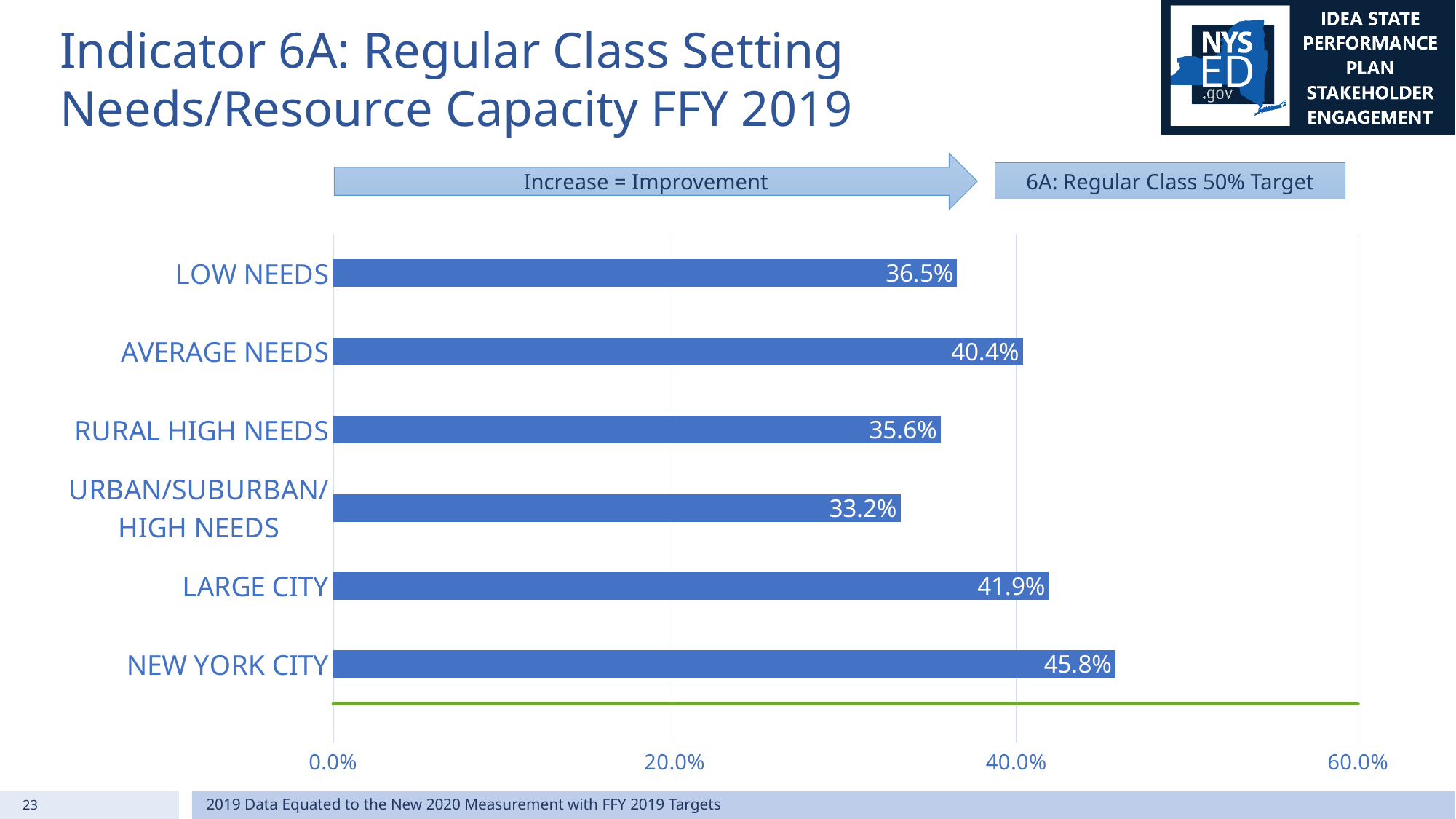
Which is larger, the value for Average Needs or the value for Rural High Needs? Average Needs What is the value for Average Needs? 40.4% What is the value for Rural High Needs? 35.6% What is the difference between the values for New York City and Large City? 3.9% What is the value for New York City? 45.8% What is the value for Urban/Suburban/High Needs? 33.2% What is the value for Low Needs? 36.5% What kind of chart is shown on the slide? Bar chart Which category has the lowest value? Urban/Suburban/High Needs Which category has the highest value? New York City Is the value for Large City greater or less than 40.0%? greater How many categories are shown in the chart? 6